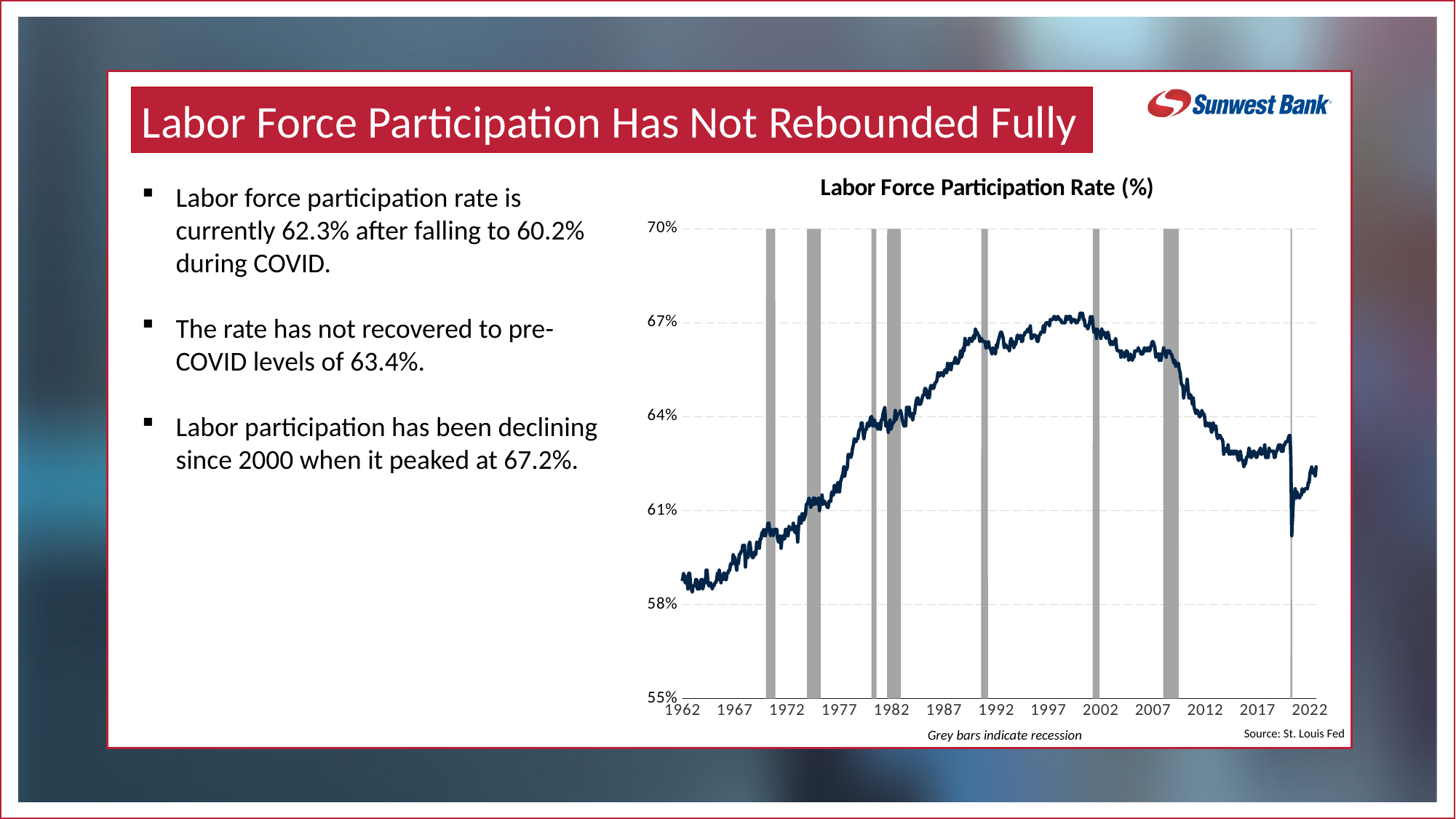
Which year has a higher labor force participation rate, 1967 or 1997? 1997 What kind of chart is shown on the slide? line chart According to the slide text, what was the peak labor force participation rate reached in 2000? 67.2% Is the labor force participation rate in 1972 greater or less than 61%? less Is the labor force participation rate in 2022 greater or less than 64%? less What do the grey bars on the chart indicate? recession Does the labor force participation rate rise or fall between 2007 and 2017? fall Is the labor force participation rate in 1962 greater or less than 58%? greater Does the labor force participation rate rise or fall between 1962 and 1997? rise What is the title of the chart? Labor Force Participation Rate (%)